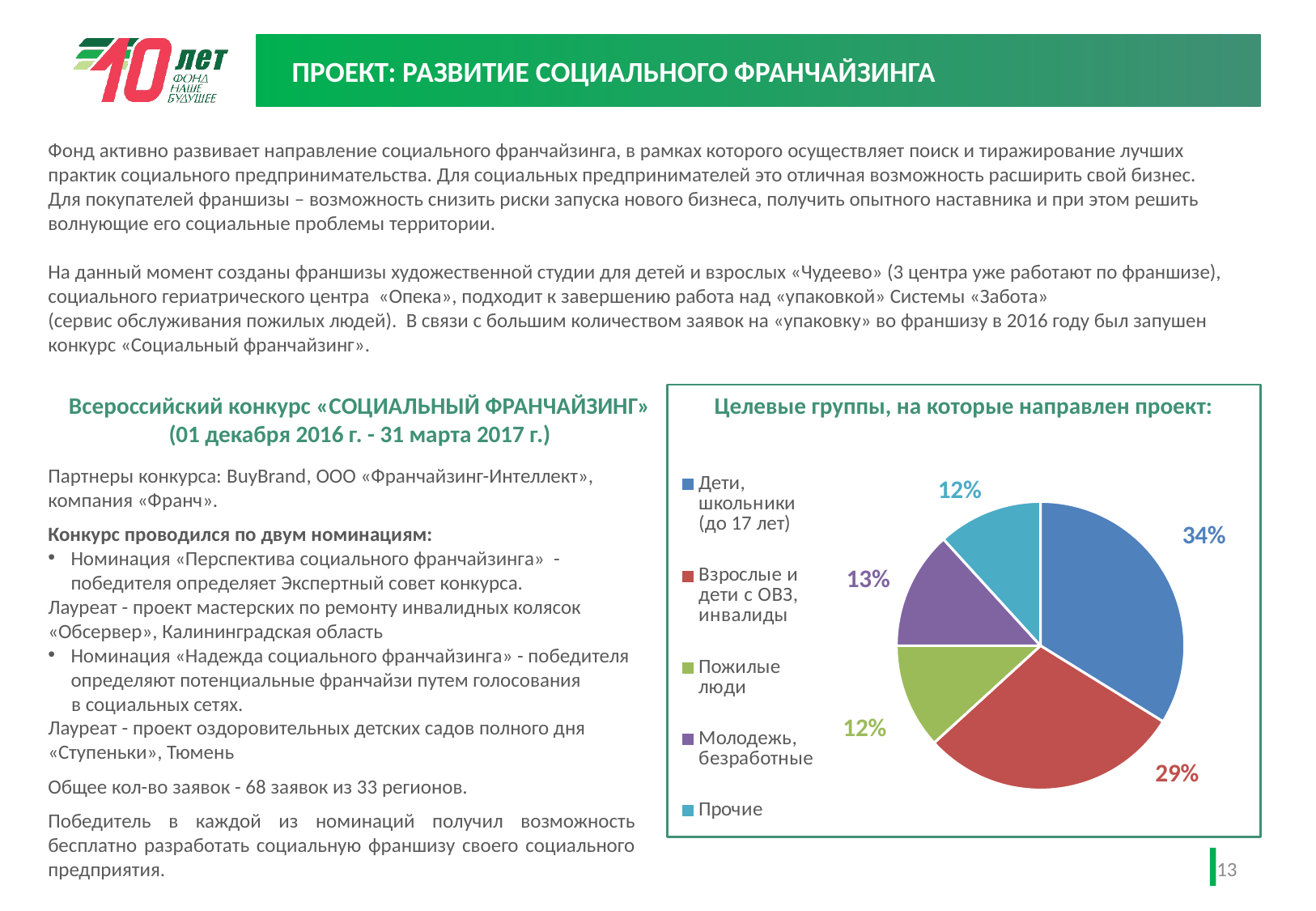
How many entries does the pie chart legend list? 5 What share of the pie chart is labelled «Дети, школьники (до 17 лет)»? 34% Which target group has the largest slice of the pie chart? Дети, школьники (до 17 лет) How many slices does the pie chart have? 5 What share of the pie chart is labelled «Прочие»? 12% What is the title of the pie chart? Целевые группы, на которые направлен проект: What is the difference in percentage points between the «Дети, школьники (до 17 лет)» slice and the «Взрослые и дети с ОВЗ, инвалиды» slice? 5% What share of the pie chart is labelled «Взрослые и дети с ОВЗ, инвалиды»? 29% What kind of chart is shown on the slide? pie chart What share of the pie chart is labelled «Молодежь, безработные»? 13% Which slice is larger: «Молодежь, безработные» or «Пожилые люди»? Молодежь, безработные What share of the pie chart is labelled «Пожилые люди»? 12%